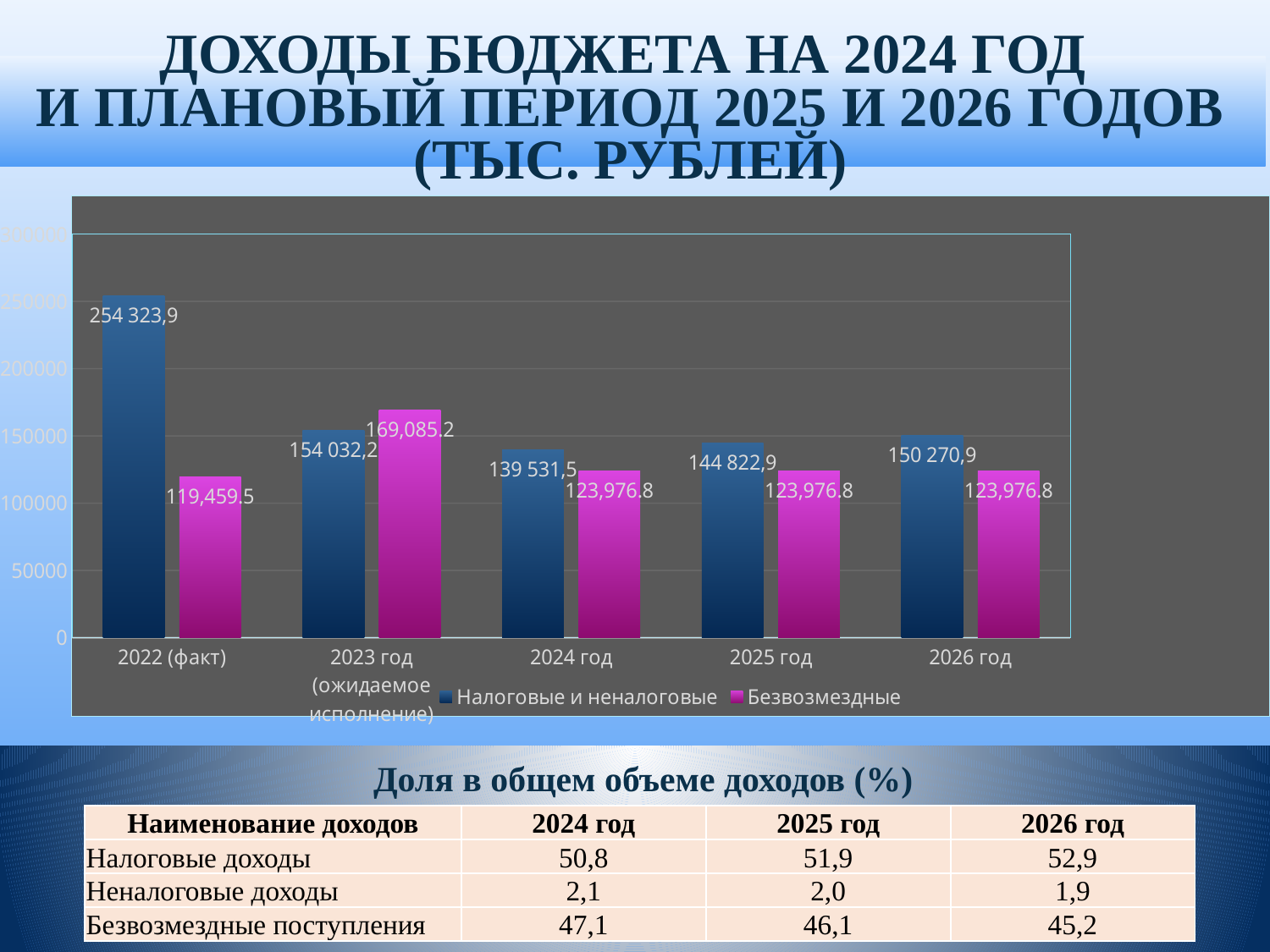
Which year has the lowest value for Налоговые и неналоговые? 2024 год Which year has the highest value for Безвозмездные? 2023 год (ожидаемое исполнение) In 2023 год, which series is larger: Налоговые и неналоговые or Безвозмездные? Безвозмездные What is the value for Налоговые и неналоговые in 2022 (факт)? 254 323,9 What is the value for Налоговые и неналоговые in 2025 год? 144 822,9 Which year has the highest value for Налоговые и неналоговые? 2022 (факт) Do the Налоговые и неналоговые values rise or fall from 2024 год to 2026 год? Rise What kind of chart is shown on the slide? Bar chart How many series does the legend list? 2 What is the value for Безвозмездные in 2023 год (ожидаемое исполнение)? 169,085.2 What is the difference between the Налоговые и неналоговые values for 2022 (факт) and 2023 год? 100 291,7 How many year categories are shown on the x axis? 5